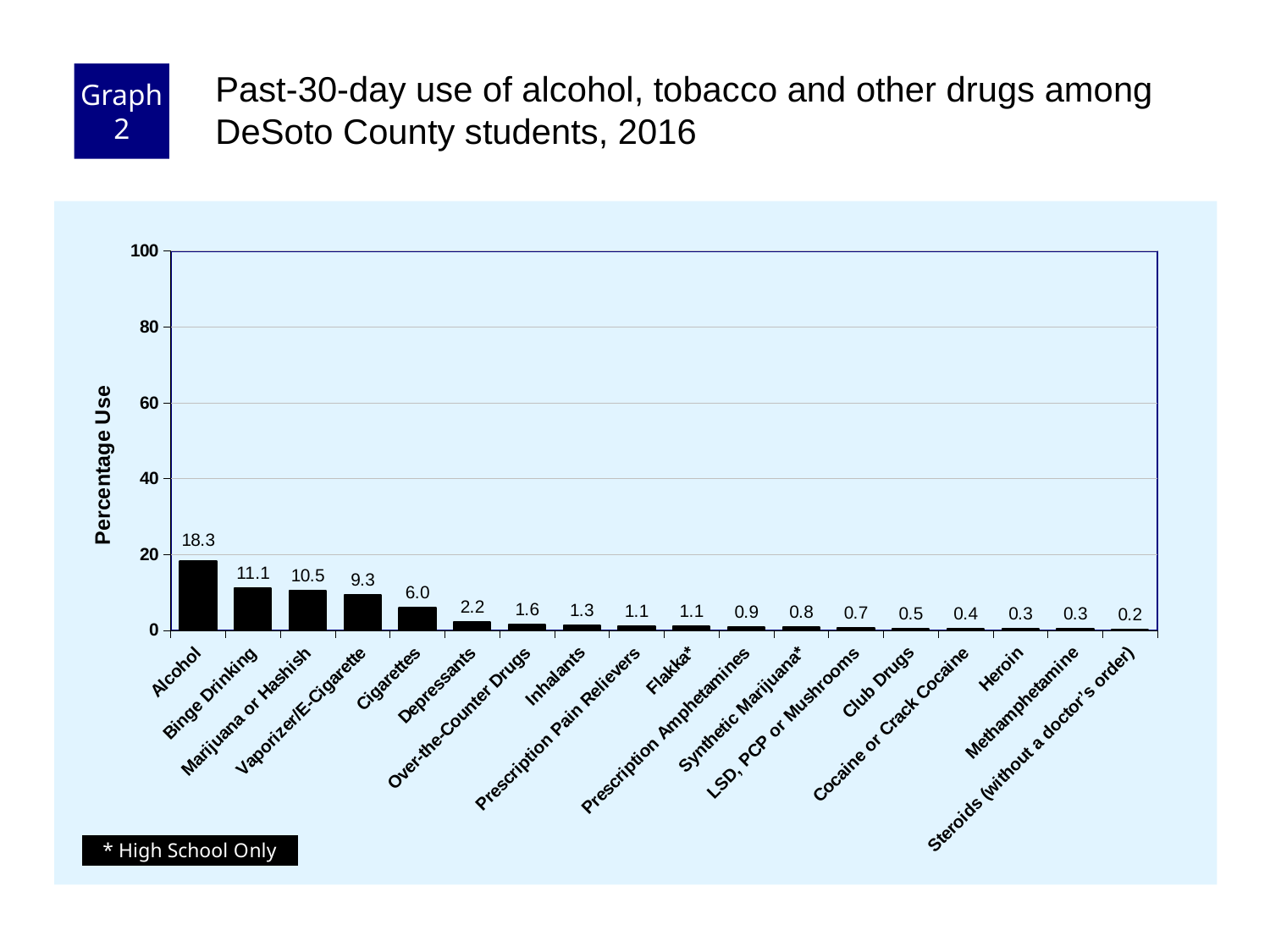
Is the value for Alcohol greater or less than 20? less What is the difference in percentage use between Alcohol and Binge Drinking? 7.2 What is the percentage use for Vaporizer/E-Cigarette? 9.3 What is the difference in percentage use between Cigarettes and Depressants? 3.8 How many categories are shown on the x axis? 18 What is the percentage use for Alcohol? 18.3 Which category has the lowest percentage use? Steroids (without a doctor's order) Which has a higher percentage use, Marijuana or Hashish or Cigarettes? Marijuana or Hashish What is the percentage use for Heroin? 0.3 What is the label of the y axis? Percentage Use Which category has the highest percentage use? Alcohol What kind of chart is shown on the slide? bar chart